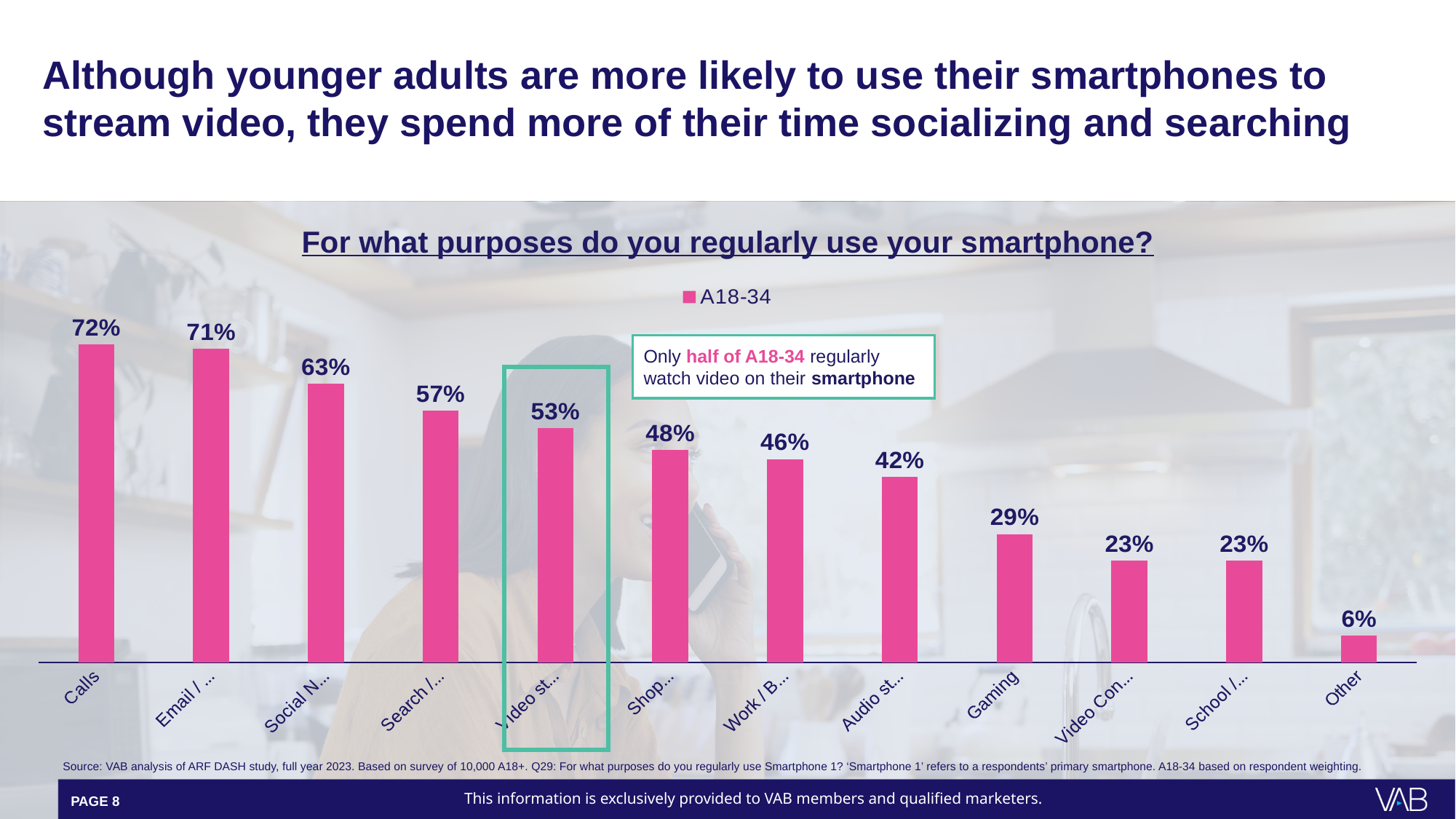
What is the value for Gaming? 29% Which category has the lowest value? Other What is the title of the chart? For what purposes do you regularly use your smartphone? What is the value for Calls? 72% What kind of chart is shown on the slide? Bar chart What is the value for Other? 6% How many categories are shown in the chart? 12 How many series does the legend list? 1 Which is larger, the value for Gaming or the value for Other? Gaming What is the difference between the values for Calls and Gaming? 43% Which category has the highest value? Calls What is the value of the bar highlighted with a green box (Video st...)? 53%